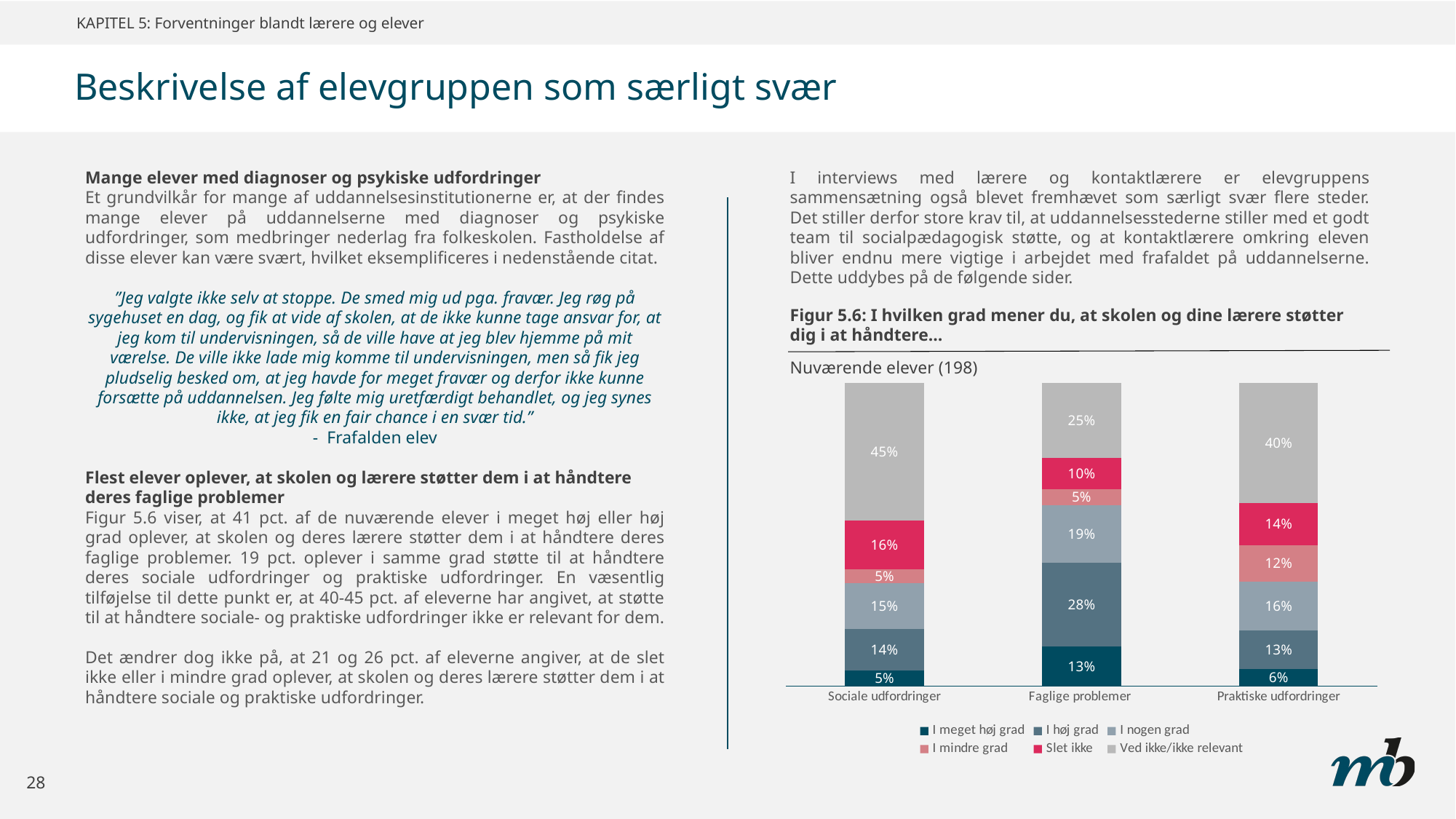
How many series does the legend of the chart list? 6 What is the number of respondents shown above the chart for 'Nuværende elever'? 198 Which is larger: the 'I nogen grad' value for 'Faglige problemer' or for 'Praktiske udfordringer'? Faglige problemer What is the difference between the 'Slet ikke' values for 'Sociale udfordringer' and 'Faglige problemer'? 6% What is the value for 'Ved ikke/ikke relevant' in the 'Sociale udfordringer' bar? 45% What kind of chart is shown in Figur 5.6? Stacked bar chart What is the value for 'I høj grad' in the 'Faglige problemer' bar? 28% Which category has the highest value for 'I meget høj grad'? Faglige problemer What is the combined total of 'I meget høj grad' and 'I høj grad' for 'Faglige problemer'? 41% How many categories are shown on the x axis of the chart? 3 Which category has the lowest value for 'Ved ikke/ikke relevant'? Faglige problemer What is the value for 'I mindre grad' in the 'Praktiske udfordringer' bar? 12%